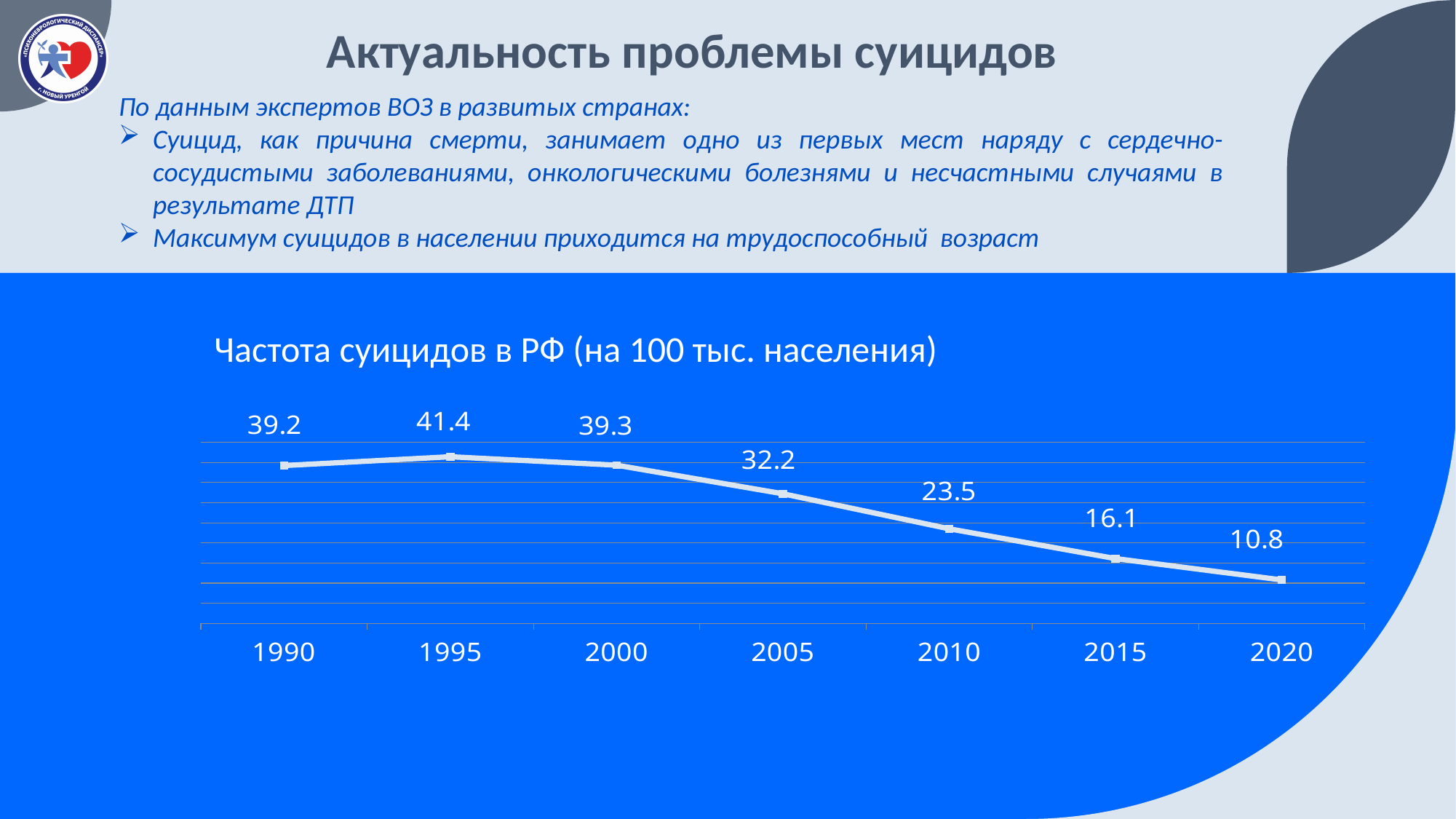
Which year has the highest value in the chart? 1995 Do the values rise or fall from 2000 to 2020? fall Which is larger, the value for 2010 or the value for 2015? 2010 What is the value for 1995 in the chart? 41.4 What kind of chart is shown on the slide? line chart What is the value for 2005 in the chart? 32.2 What is the difference between the values for 2005 and 2010? 8.7 How many data points are plotted in the chart? 7 What is the title of the chart? Частота суицидов в РФ (на 100 тыс. населения) What is the difference between the values for 1995 and 2020? 30.6 What is the value for 2020 in the chart? 10.8 Which year has the lowest value in the chart? 2020